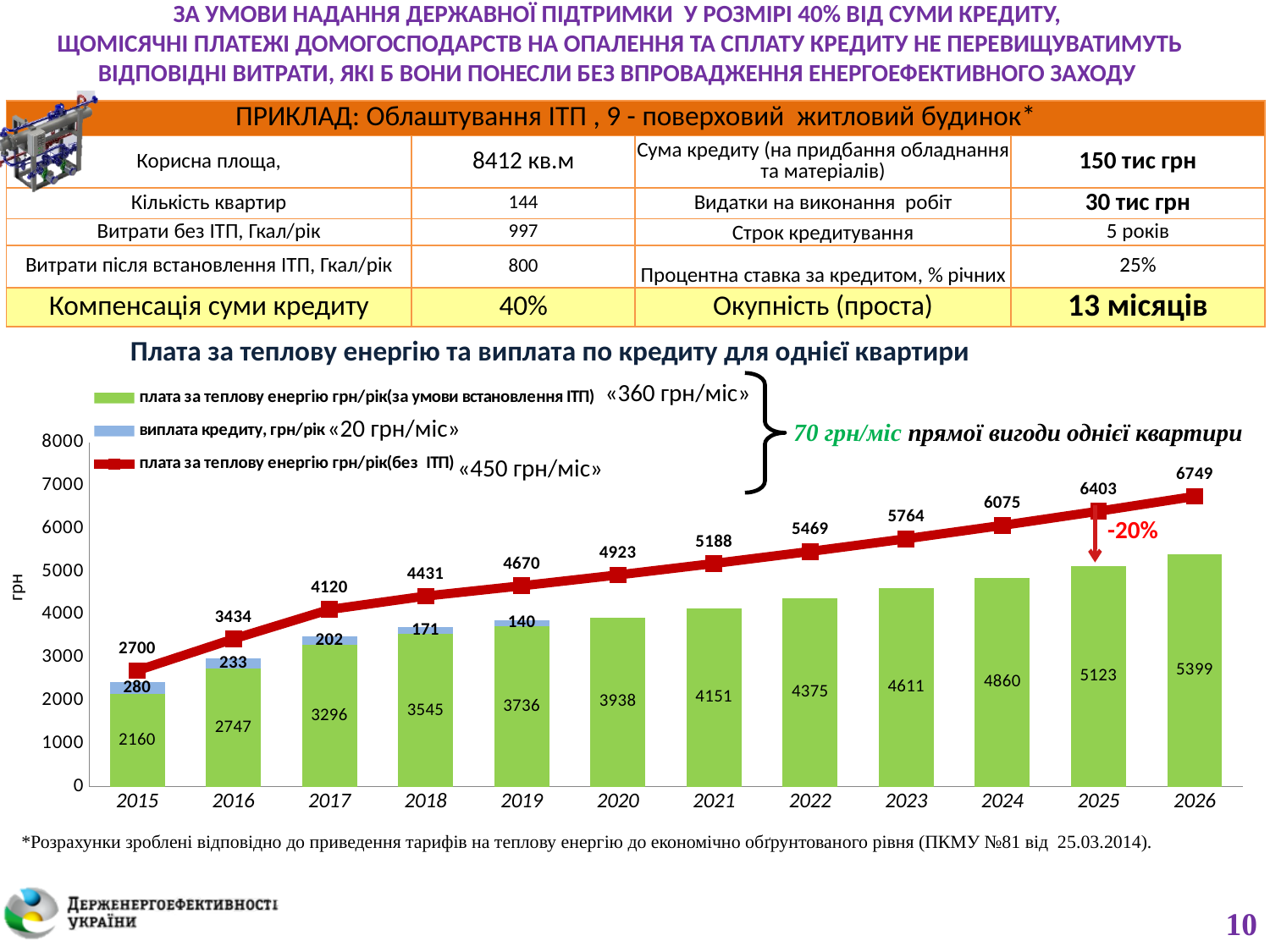
What is the value of the red line (плата за теплову енергію грн/рік без ІТП) for 2026? 6749 What is the credit payment (виплата кредиту) value shown for 2017? 202 In which year does the red line (без ІТП) reach its highest value? 2026 Do the values of the red line rise or fall from 2015 to 2026? rise What is the total of the stacked bar (green plus blue) for 2015? 2440 What is the difference between the red line value and the green bar value in 2026? 1350 In which year is the green bar (за умови встановлення ІТП) lowest? 2015 What is the value of the green series (плата за теплову енергію грн/рік за умови встановлення ІТП) for 2015? 2160 Which is larger in 2020: the red line value or the green bar value? the red line value (4923) What is the title of the chart? Плата за теплову енергію та виплата по кредиту для однієї квартири How many years are shown on the x axis of the chart? 12 How many series does the chart legend list? 3